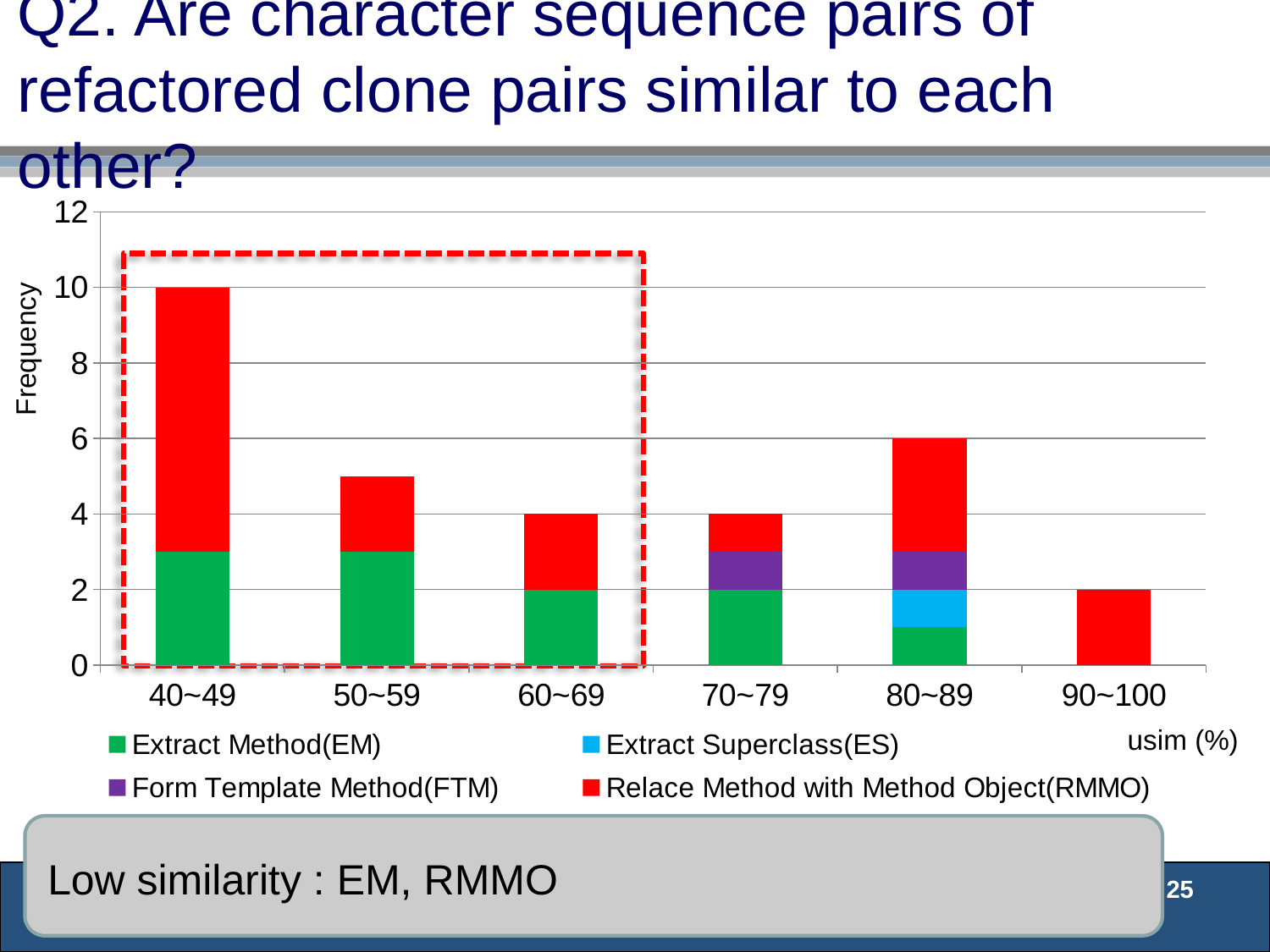
What kind of chart is shown on the slide? stacked bar chart What is the Extract Method(EM) frequency in the 60~69 category? 2 Which has a larger total frequency, the 80~89 category or the 70~79 category? 80~89 What is the total frequency of the stacked bar for the 80~89 category? 6 How many series does the legend list? 4 How many usim (%) categories are shown on the x axis? 6 Is the total frequency for the 50~59 category greater or less than 4? greater What is the total frequency of the stacked bar for the 90~100 category? 2 Which usim (%) category has the highest total frequency? 40~49 What is the total frequency of the stacked bar for the 40~49 category? 10 Which category is the only one that includes the Extract Superclass(ES) series? 80~89 Which usim (%) category has the lowest total frequency? 90~100